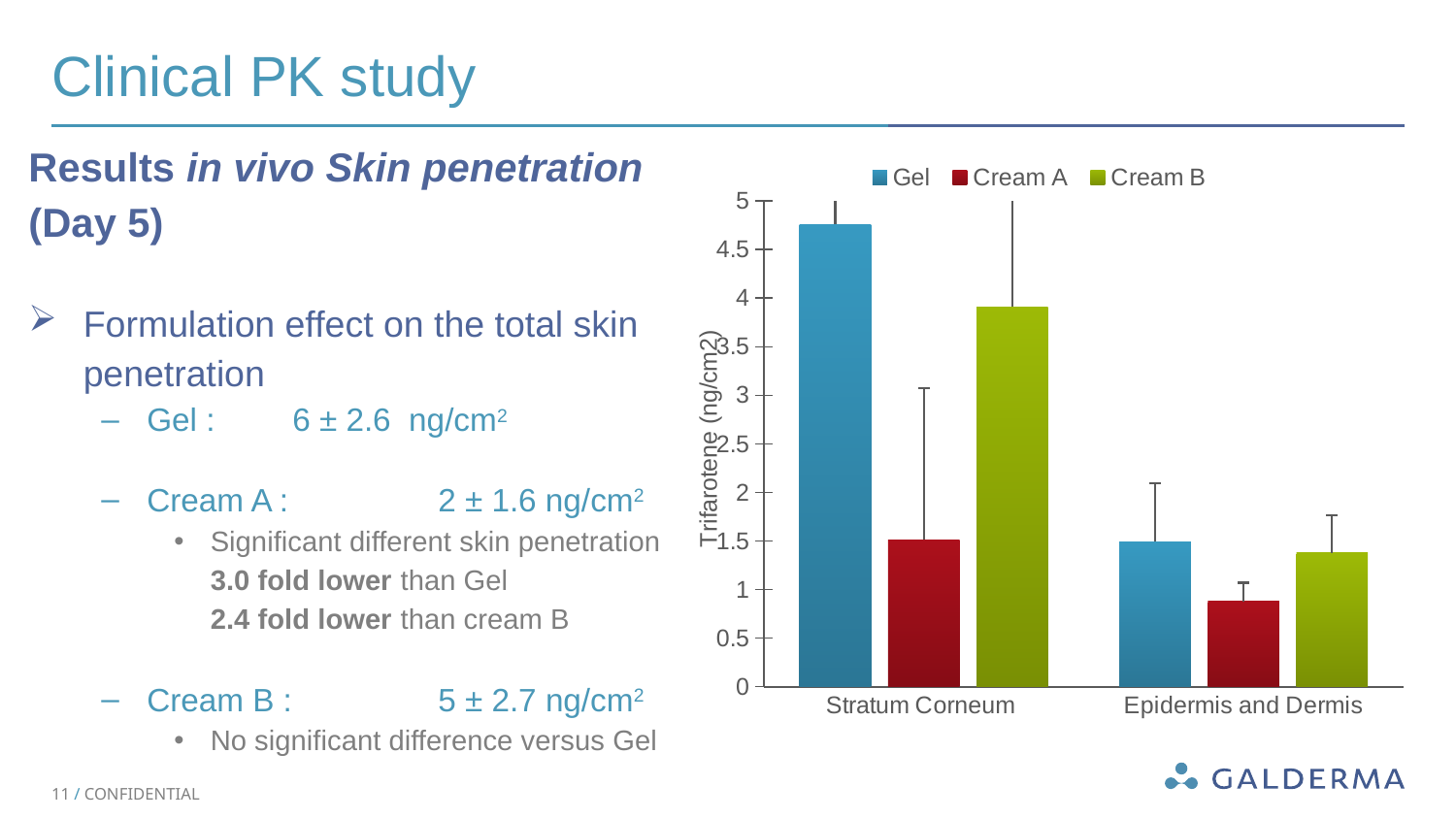
Is the Cream A value for Epidermis and Dermis greater or less than 1? less What kind of chart is shown on the slide? bar chart Is the Gel value for Stratum Corneum greater or less than 4.5? greater Which series has the highest bar in the Stratum Corneum category? Gel How many series does the chart legend list? 3 Which series has the lowest bar in the Epidermis and Dermis category? Cream A In the Stratum Corneum category, which is larger: the Gel bar or the Cream A bar? Gel Which bar is the tallest in the whole chart? Gel in Stratum Corneum Is the Cream B value for Stratum Corneum greater or less than 3.5? greater What is the label on the y axis of the chart? Trifarotene (ng/cm2) In the Epidermis and Dermis category, which is larger: the Cream A bar or the Cream B bar? Cream B How many categories are shown on the x axis of the chart? 2